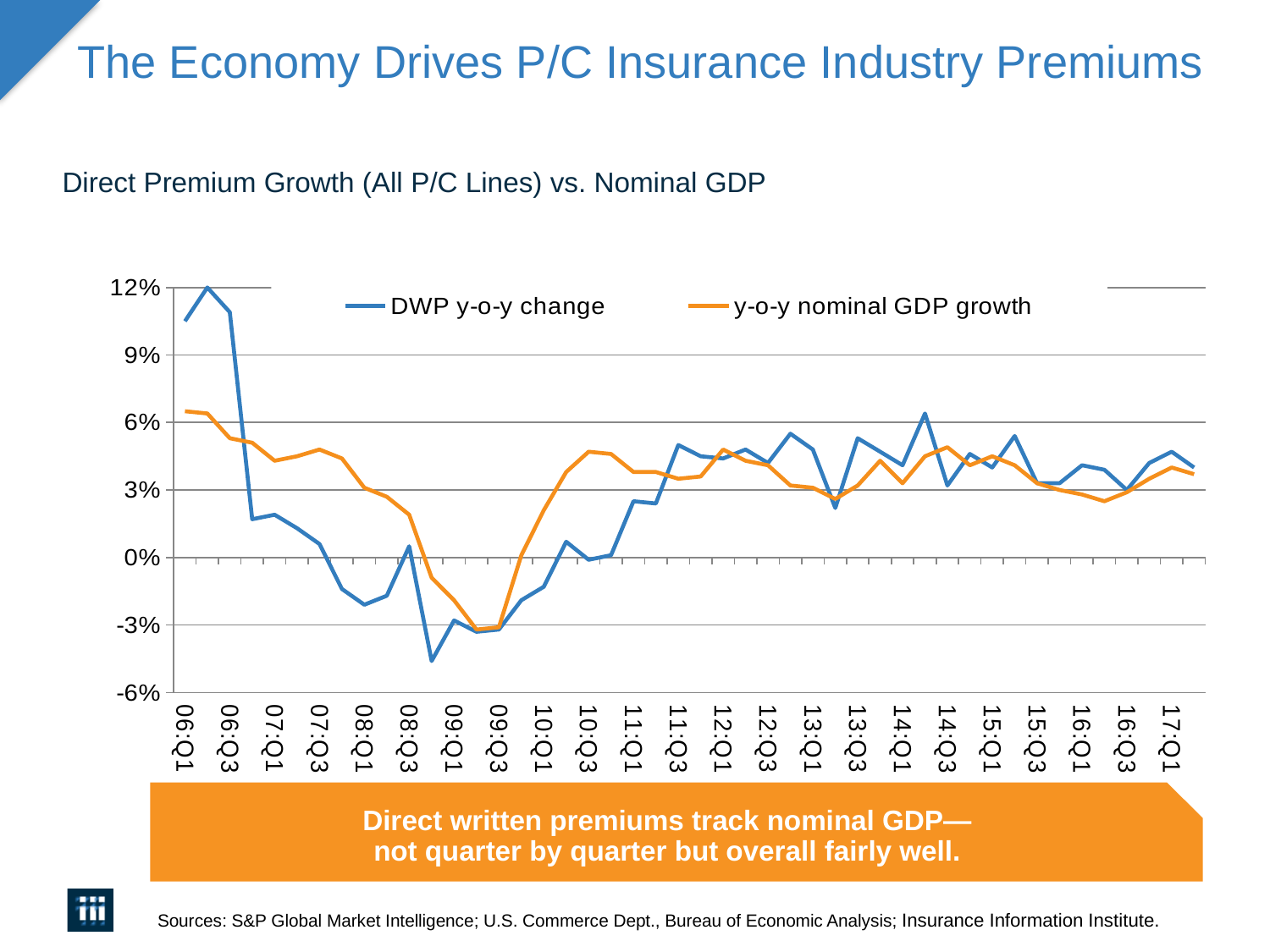
Does the DWP y-o-y change line rise or fall from 06:Q1 to 07:Q1? fall At 06:Q1, which series has the higher value, DWP y-o-y change or y-o-y nominal GDP growth? DWP y-o-y change What kind of chart is shown on the slide? Line chart How many quarter labels are shown on the x axis? 23 Is the DWP y-o-y change at 08:Q1 greater or less than 0%? less How many series does the legend list? 2 Is the DWP y-o-y change at 06:Q1 greater or less than 9%? greater At 09:Q1, which series has the higher value, DWP y-o-y change or y-o-y nominal GDP growth? y-o-y nominal GDP growth Which series is drawn in orange? y-o-y nominal GDP growth Is the y-o-y nominal GDP growth at 10:Q3 greater or less than 3%? greater What are the two series named in the legend? DWP y-o-y change; y-o-y nominal GDP growth